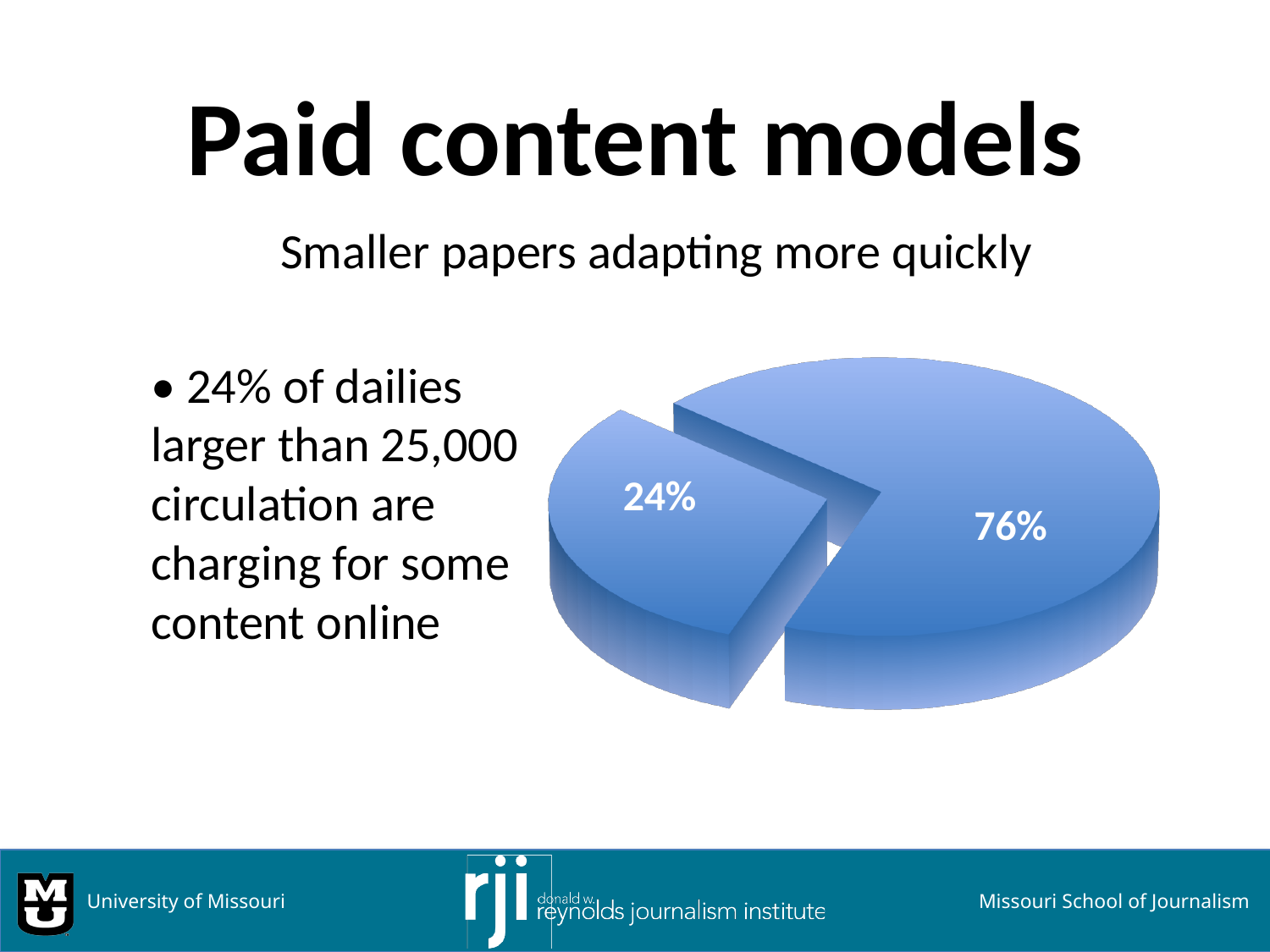
How many slices does the pie chart have? 2 What is the difference in percentage points between the two slices of the pie chart? 52 What is the value of the smallest slice in the pie chart? 24% What colour are the slices of the pie chart? blue What is the title of the slide containing the pie chart? Paid content models Which slice is larger, the one labelled 24% or the one labelled 76%? 76% What is the value of the largest slice in the pie chart? 76% What percentage is labelled on the slice that is pulled out from the rest of the pie? 24% What do the two slices of the pie chart add up to? 100% Is the larger slice of the pie chart greater or less than 50%? greater What kind of chart is shown on the slide? pie chart What share of the pie does the smaller slice represent? 24%